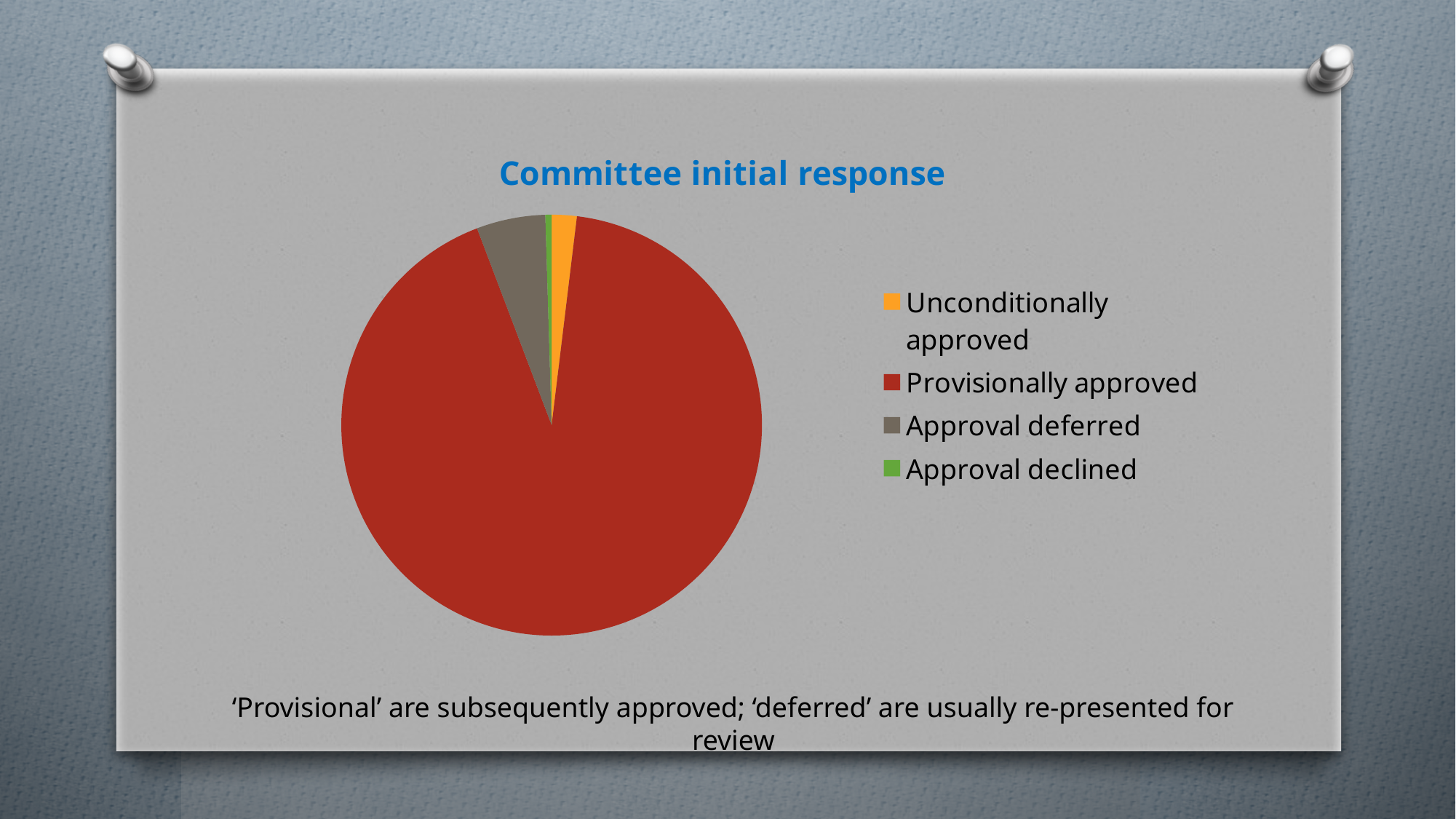
What kind of chart is shown on the slide? Pie chart Which slice is larger: Approval deferred or Unconditionally approved? Approval deferred How many entries does the legend list? 4 What is the title of the chart? Committee initial response Which category has the smallest slice of the pie? Approval declined What colour is the slice for Approval deferred? Grey How many categories does the pie chart have? 4 Which slice is larger: Provisionally approved or Approval deferred? Provisionally approved Which category has the largest slice of the pie? Provisionally approved Which slice is larger: Unconditionally approved or Approval declined? Unconditionally approved